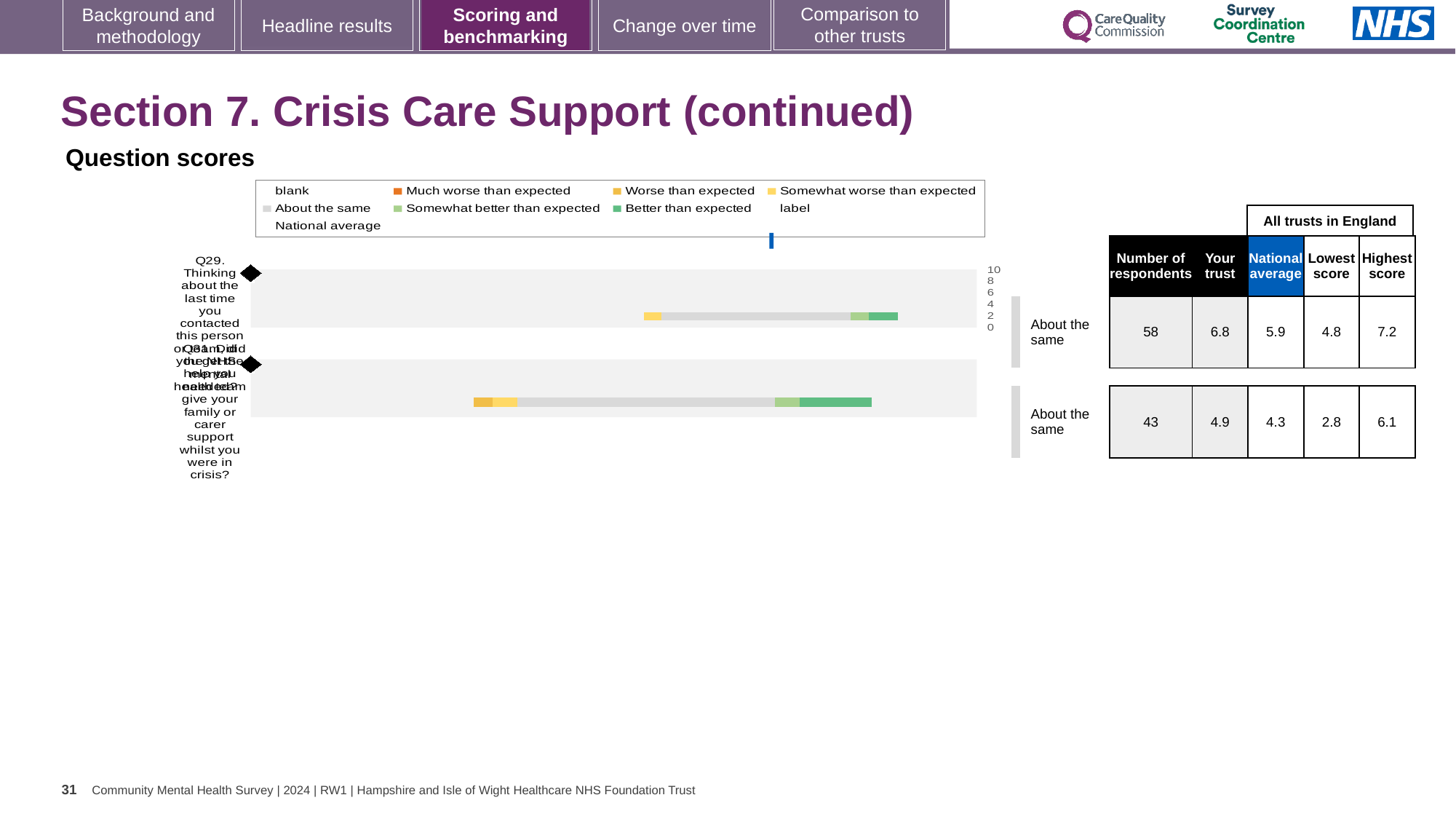
What is the maximum value shown on the chart's score axis? 10 What is the highest score among all trusts in England for Q29? 7.2 What is the difference between the highest and lowest scores for Q31? 3.3 For Q29, which is larger: the 'Your trust' score or the national average? Your trust What is the number of respondents for Q29 in the table next to the chart? 58 What is the 'Your trust' score for Q29? 6.8 How many questions (bars) are plotted in the chart? 2 What kind of chart is shown under 'Question scores'? bar chart What is the national average score for Q31? 4.3 What is the lowest score among all trusts in England for Q31? 2.8 What benchmark category is shown for both Q29 and Q31? About the same Which colour in the legend represents 'Better than expected'? green